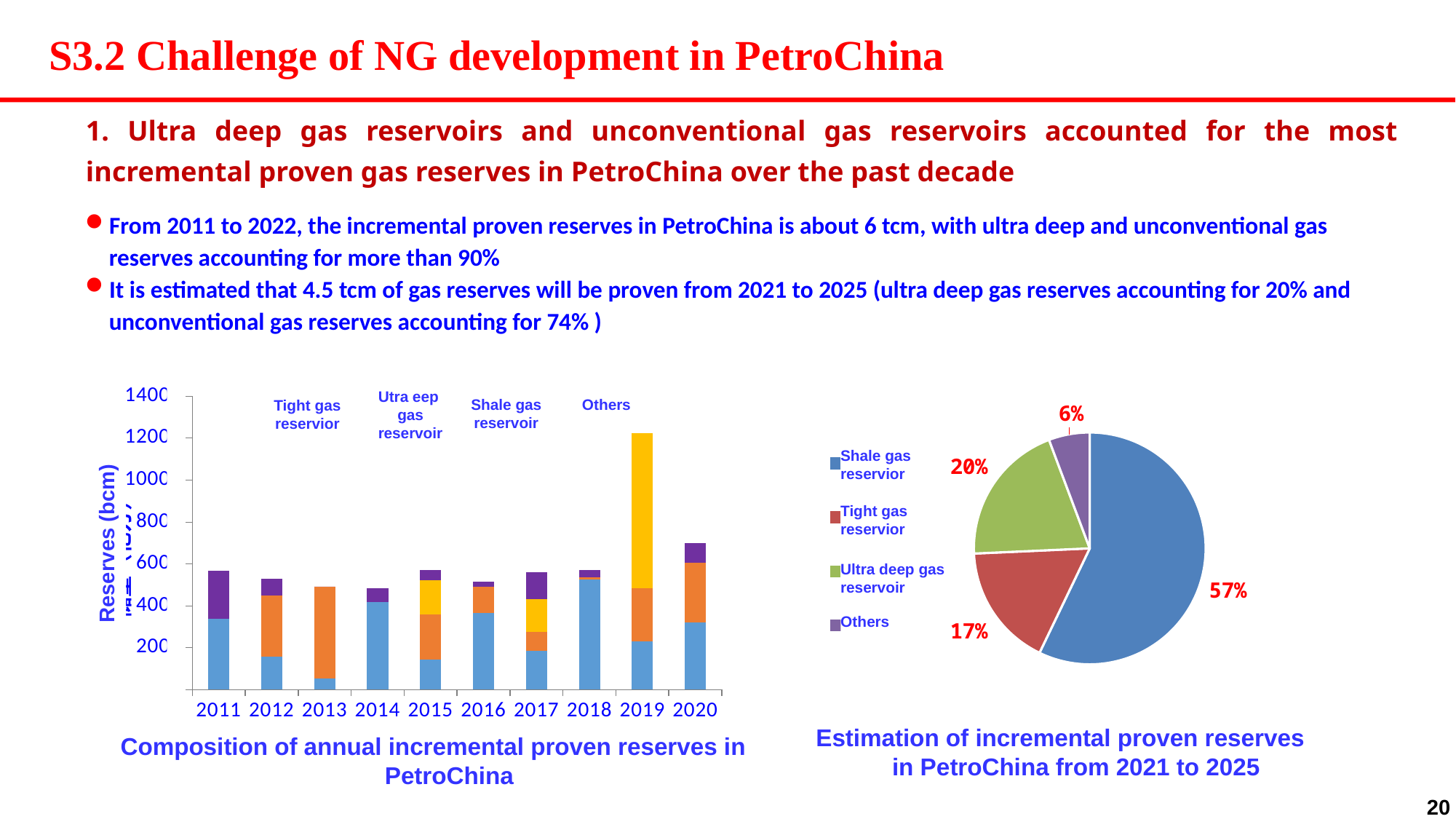
In the pie chart 'Estimation of incremental proven reserves in PetroChina from 2021 to 2025', what share is Ultra deep gas reservoir? 20% In the pie chart 'Estimation of incremental proven reserves in PetroChina from 2021 to 2025', how many percentage points larger is the Shale gas reservoir share than the Tight gas reservoir share? 40 In the bar chart 'Composition of annual incremental proven reserves in PetroChina', which year has the highest total bar? 2019 In the pie chart 'Estimation of incremental proven reserves in PetroChina from 2021 to 2025', which is larger: Ultra deep gas reservoir or Tight gas reservoir? Ultra deep gas reservoir In the pie chart 'Estimation of incremental proven reserves in PetroChina from 2021 to 2025', which category has the smallest share? Others In the bar chart 'Composition of annual incremental proven reserves in PetroChina', is the total for 2019 greater or less than 1000? greater In the pie chart 'Estimation of incremental proven reserves in PetroChina from 2021 to 2025', which category has the largest share? Shale gas reservoir What kind of chart is 'Composition of annual incremental proven reserves in PetroChina'? Stacked bar chart How many entries does the legend of the pie chart 'Estimation of incremental proven reserves in PetroChina from 2021 to 2025' list? 4 In the pie chart 'Estimation of incremental proven reserves in PetroChina from 2021 to 2025', what share is Tight gas reservoir? 17% How many years are shown on the x axis of the bar chart 'Composition of annual incremental proven reserves in PetroChina'? 10 In the pie chart 'Estimation of incremental proven reserves in PetroChina from 2021 to 2025', what share is Shale gas reservoir? 57%